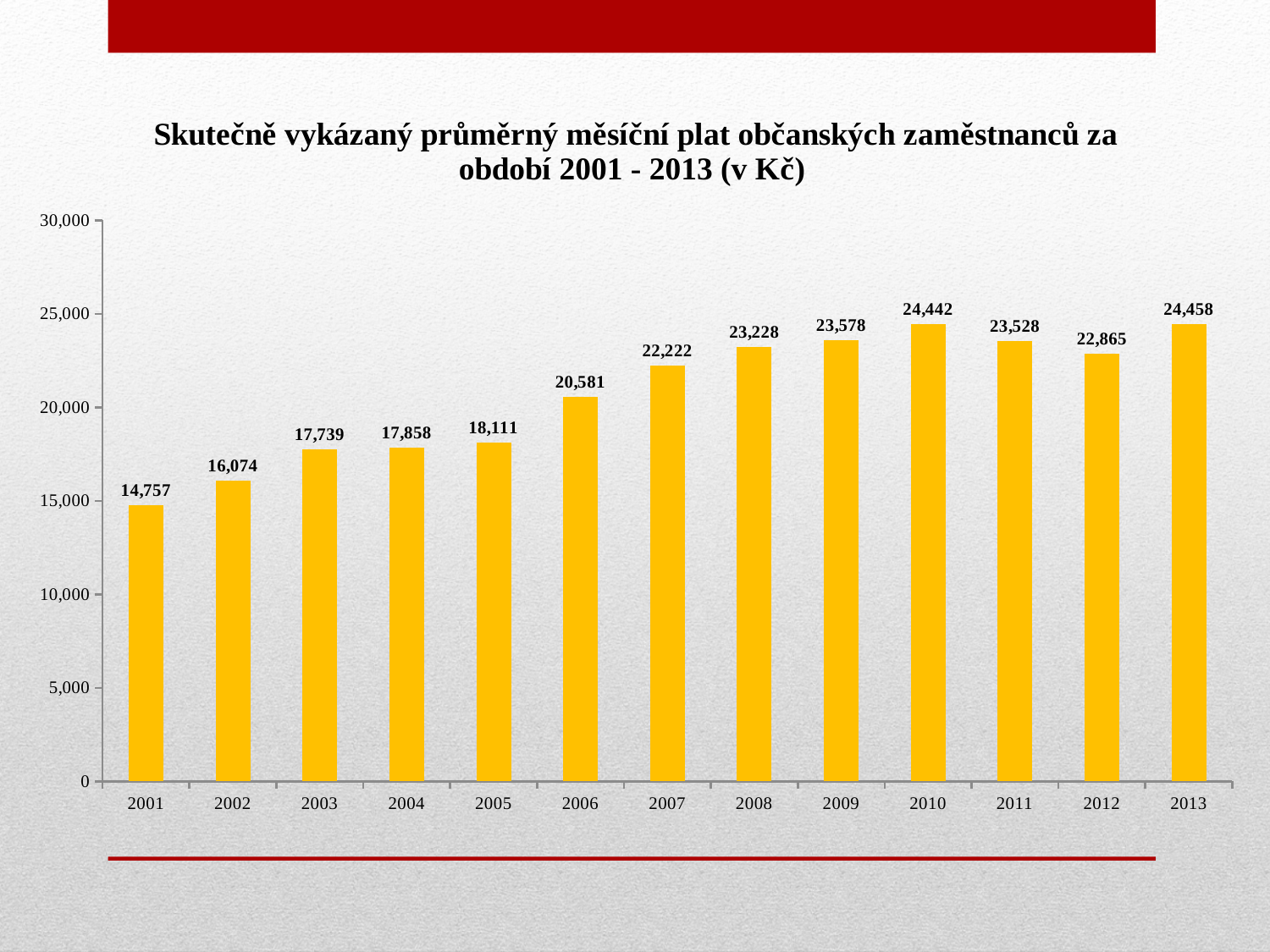
What is the value for 2006? 20,581 What is the title of the chart? Skutečně vykázaný průměrný měsíční plat občanských zaměstnanců za období 2001 - 2013 (v Kč) What kind of chart is this? bar chart Which is larger, the value for 2011 or the value for 2012? 2011 Which year has the lowest value? 2001 How many years are shown on the x axis? 13 Do the values generally rise or fall from 2001 to 2010? rise What is the difference between the values for 2011 and 2012? 663 What is the value for 2001? 14,757 Is the value for 2007 greater or less than 20,000? greater What is the value for 2010? 24,442 What is the difference between the values for 2013 and 2001? 9,701